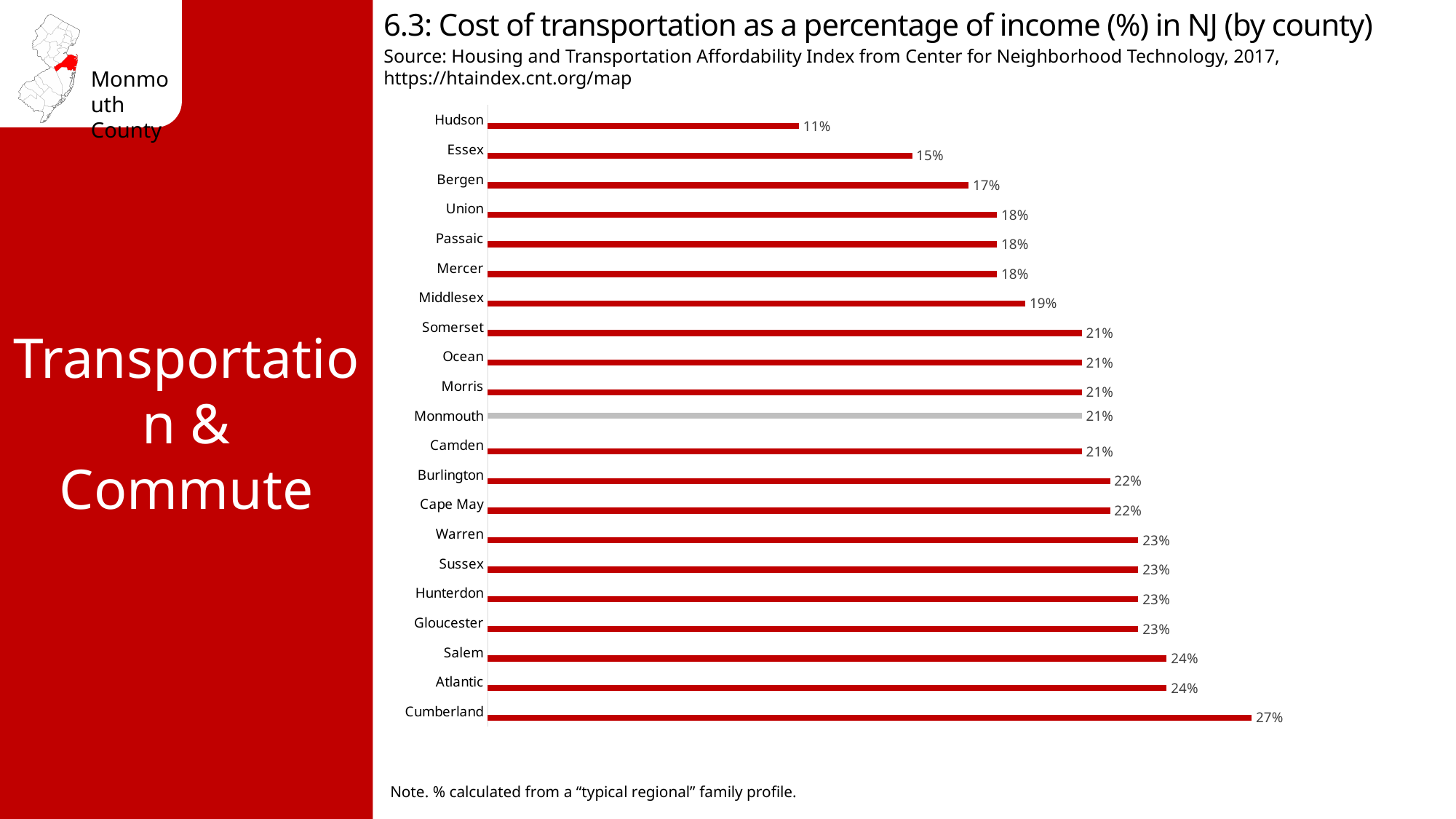
Which county's bar is shown in grey rather than red? Monmouth What is the value shown for Middlesex County? 19% Which county has the highest cost of transportation as a percentage of income? Cumberland What type of chart is shown on the slide? Bar chart What is the difference between the values for Monmouth and Essex? 6% What is the cost of transportation as a percentage of income for Monmouth County? 21% What is the title of the chart? 6.3: Cost of transportation as a percentage of income (%) in NJ (by county) What is the difference between the values for Cumberland and Hudson? 16% Which has a higher value, Bergen or Salem? Salem How many counties are shown in the chart? 21 What is the value shown for Hudson County? 11% Which county has the lowest cost of transportation as a percentage of income? Hudson